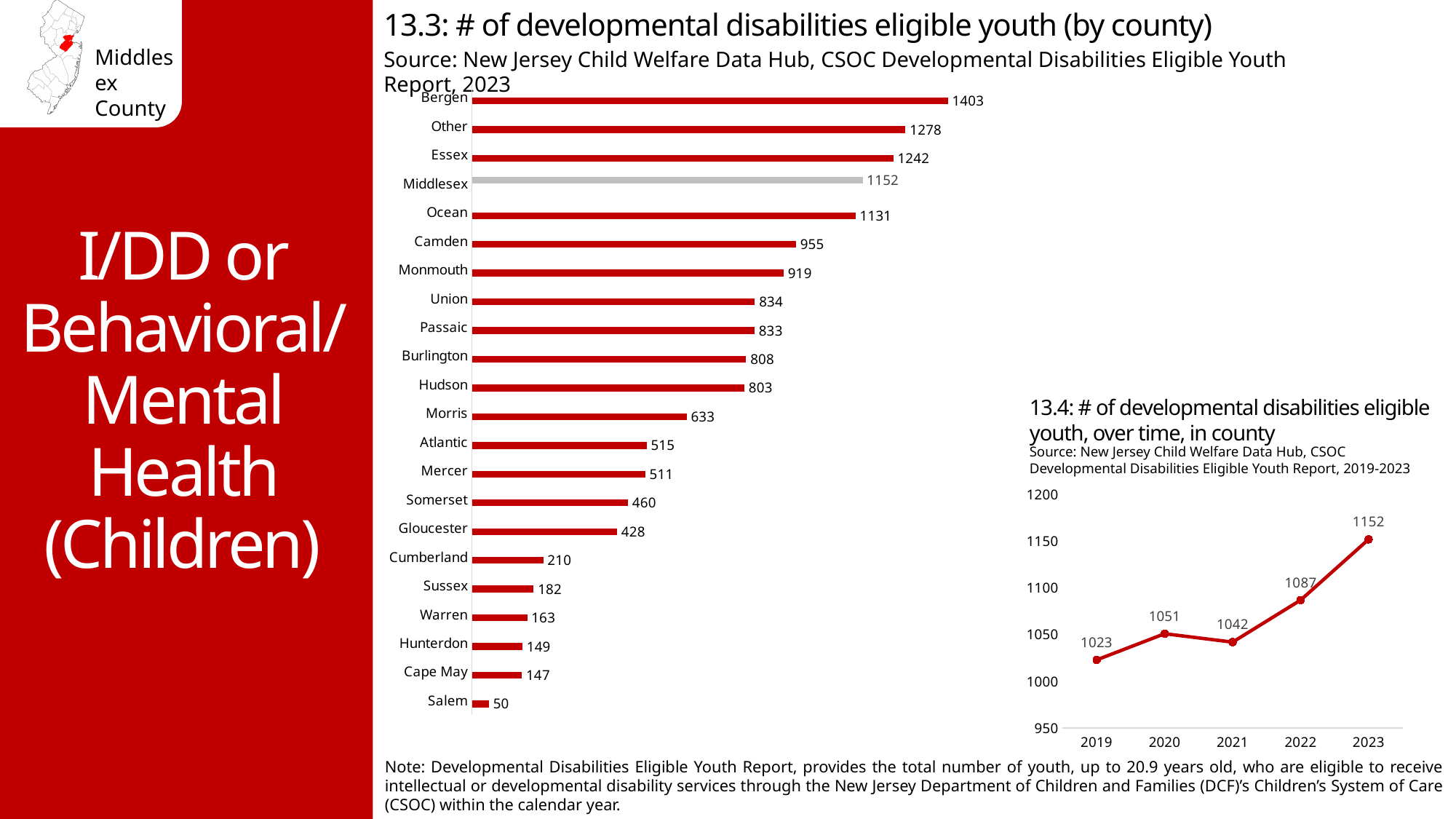
In chart 13.3 (# of developmental disabilities eligible youth by county), what is the value for Middlesex? 1152 In chart 13.3 (by county), which county has the lowest number of developmental disabilities eligible youth? Salem In chart 13.3 (by county), which has a larger value, Camden or Monmouth? Camden In chart 13.4 (over time, in county), which year has the highest value? 2023 What type of chart is chart 13.4 (# of developmental disabilities eligible youth over time, in county)? Line chart In chart 13.3 (by county), which county has the highest number of developmental disabilities eligible youth? Bergen In chart 13.4 (over time, in county), what is the difference between the 2023 and 2019 values? 129 In chart 13.4 (over time, in county), what is the value for 2021? 1042 In chart 13.3 (by county), what is the value for Ocean? 1131 In chart 13.3 (by county), what is the difference between the values for Bergen and Middlesex? 251 In chart 13.3 (by county), how many bars (categories) are shown? 22 What type of chart is chart 13.3 (# of developmental disabilities eligible youth by county)? Bar chart